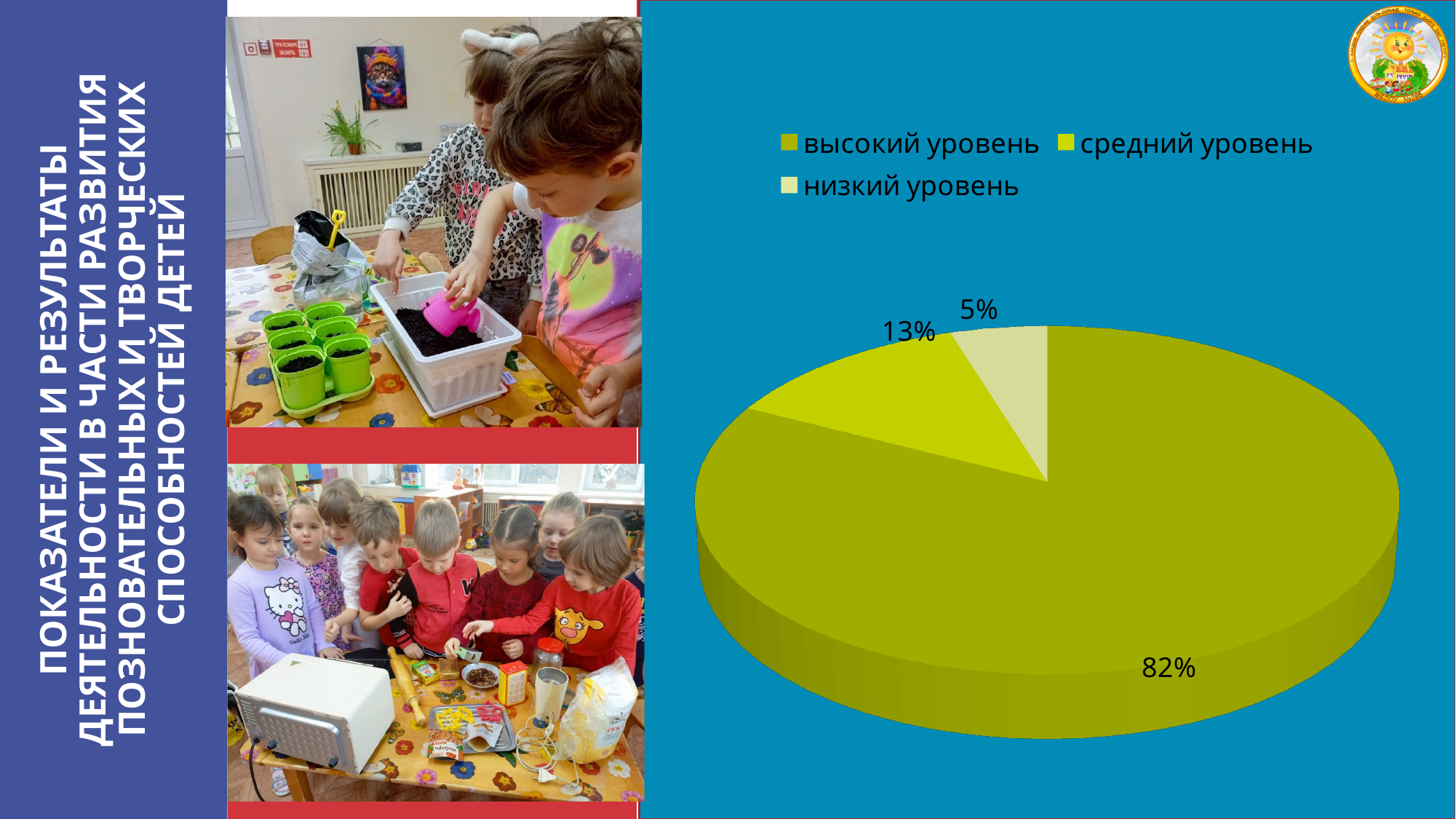
Which category has the smallest slice of the pie? низкий уровень Which category has the largest slice of the pie? высокий уровень Which is larger, the slice for "средний уровень" or the slice for "низкий уровень"? средний уровень What is the difference in percentage points between "высокий уровень" and "средний уровень"? 69 What share of the pie is labelled for "высокий уровень"? 82% What share of the pie is labelled for "средний уровень"? 13% What kind of chart is shown on the slide? pie chart What share of the pie is labelled for "низкий уровень"? 5% Which legend entry is shown with the lightest colour? низкий уровень What is the difference in percentage points between "средний уровень" and "низкий уровень"? 8 How many slices does the pie chart have? 3 How many entries does the legend list? 3